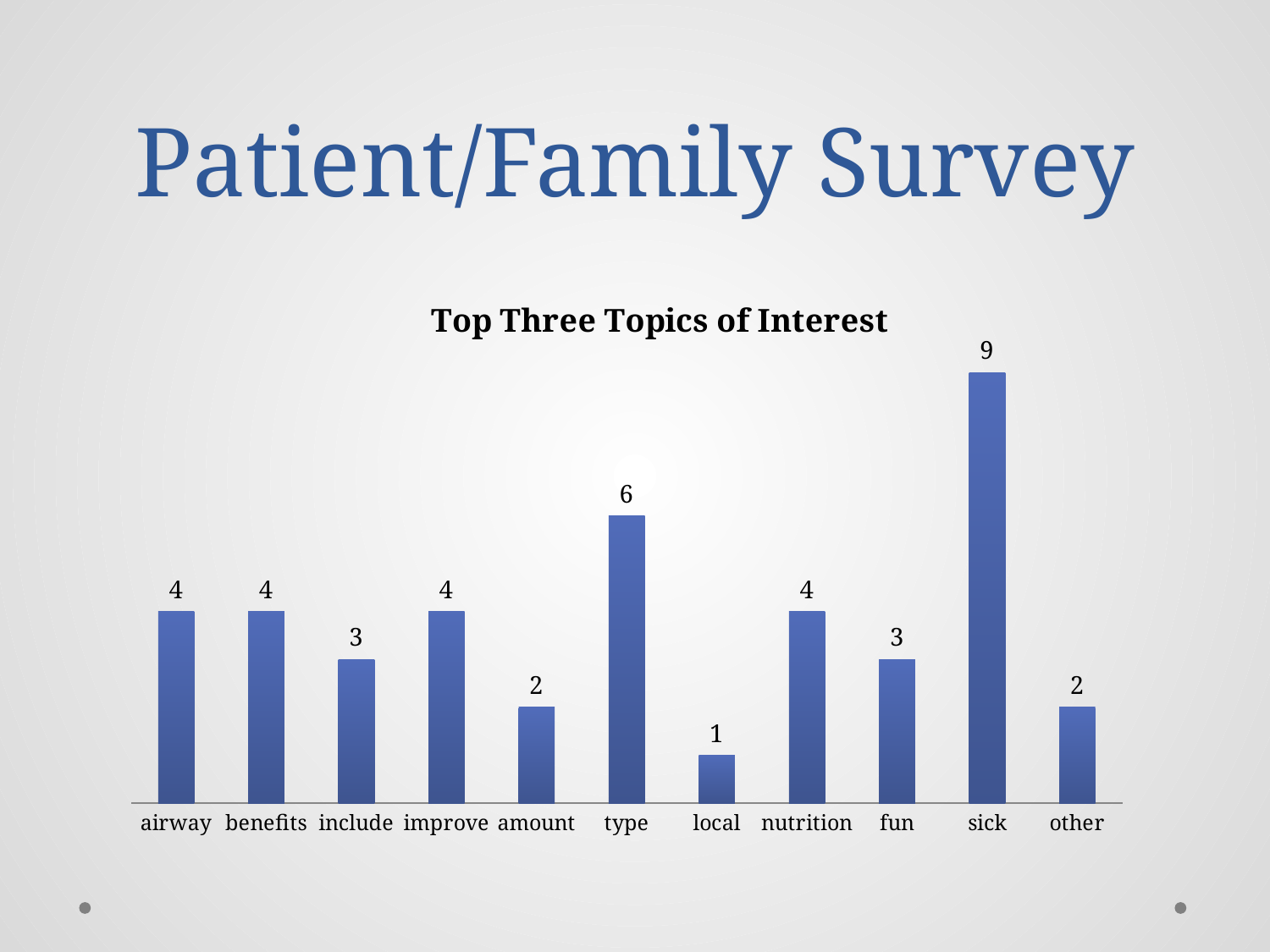
What is the value for "local"? 1 What is the difference between the values for "sick" and "type"? 3 What is the difference between the values for "include" and "amount"? 1 Which is larger, the value for "fun" or the value for "other"? fun What kind of chart is this? bar chart Which category has the highest value? sick Which category has the lowest value? local What is the title of the chart? Top Three Topics of Interest What is the value for "sick"? 9 What is the value for "nutrition"? 4 What is the value for "type"? 6 How many categories are shown on the x axis? 11